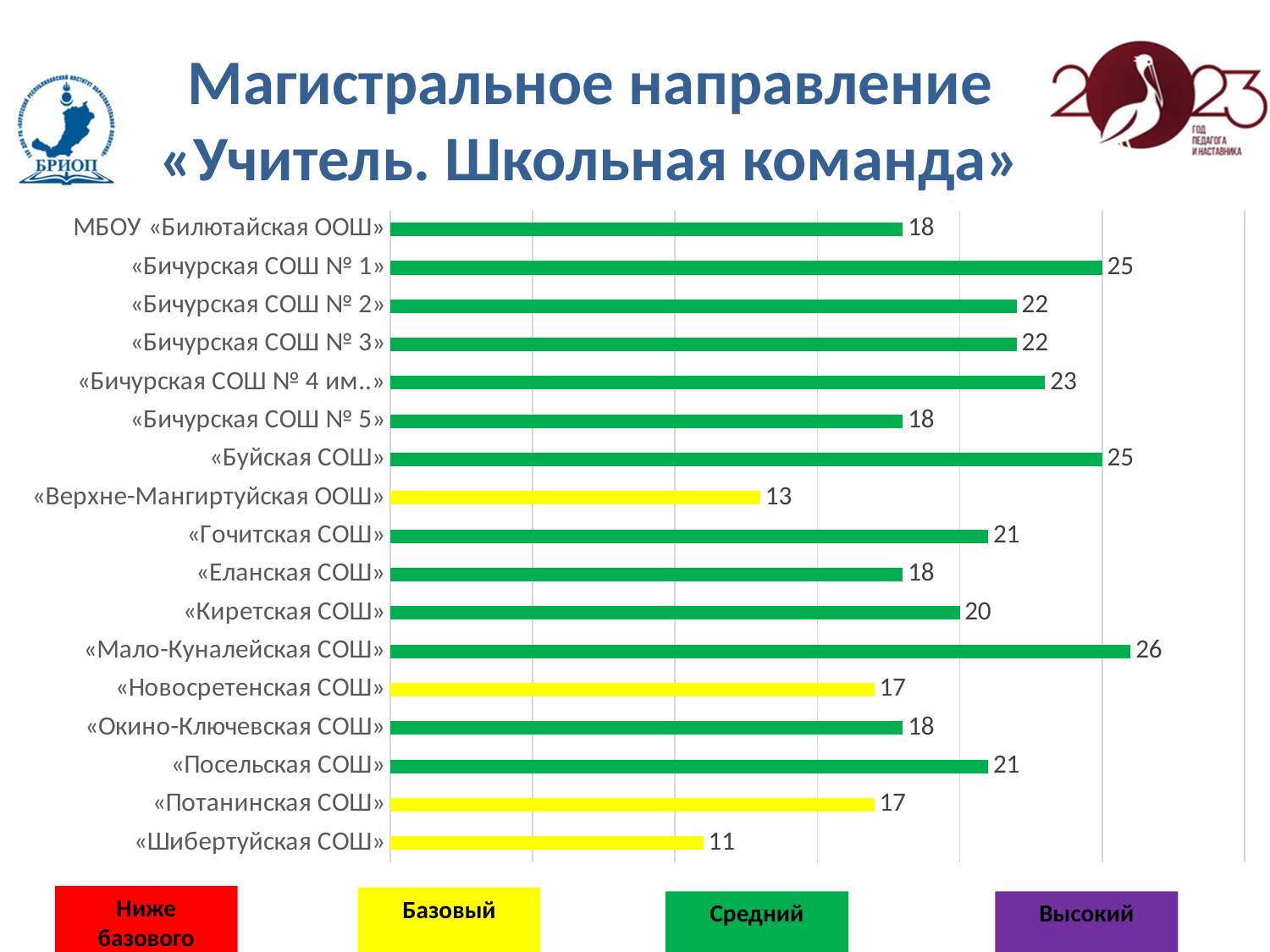
What is the difference between the values for «Бичурская СОШ № 1» and «Шибертуйская СОШ»? 14 What value is shown for «Мало-Куналейская СОШ»? 26 What is the difference between the values for «Гочитская СОШ» and «Новосретенская СОШ»? 4 What value is shown for «Киретская СОШ»? 20 How many bars on the chart are coloured yellow? 4 How many schools are shown on the chart? 17 What value is shown for «Бичурская СОШ № 4 им..»? 23 Which school has the highest value on the chart? «Мало-Куналейская СОШ» Which has a larger value, «Буйская СОШ» or «Еланская СОШ»? «Буйская СОШ» What value is shown for «Верхне-Мангиртуйская ООШ»? 13 What kind of chart is shown on the slide? Bar chart Which school has the lowest value on the chart? «Шибертуйская СОШ»